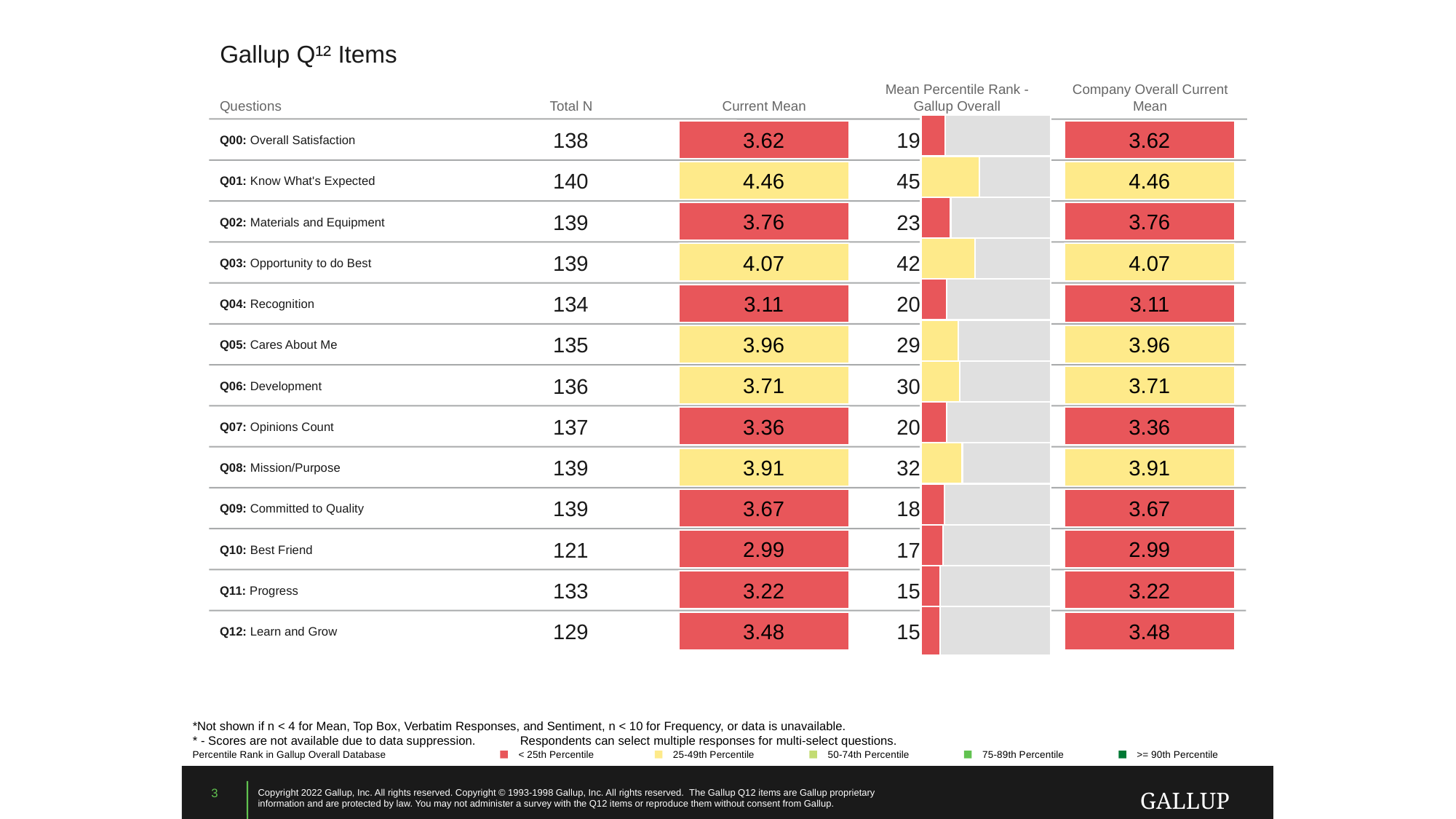
How many percentile categories does the legend list? 5 Which question has the highest Mean Percentile Rank - Gallup Overall? Q01: Know What's Expected How many Q12 items (questions) are listed in the chart? 13 What is the Total N for Q10: Best Friend? 121 What kind of chart is used in the Mean Percentile Rank - Gallup Overall column? Bar chart What is the Current Mean for Q01: Know What's Expected? 4.46 Which has a higher Current Mean, Q02: Materials and Equipment or Q06: Development? Q02: Materials and Equipment What colour are the bars for items in the < 25th Percentile category? Red Which question has the highest Current Mean? Q01: Know What's Expected What is the Mean Percentile Rank - Gallup Overall for Q05: Cares About Me? 29 Which question has the lowest Current Mean? Q10: Best Friend What is the difference in Mean Percentile Rank between Q01: Know What's Expected and Q03: Opportunity to do Best? 3